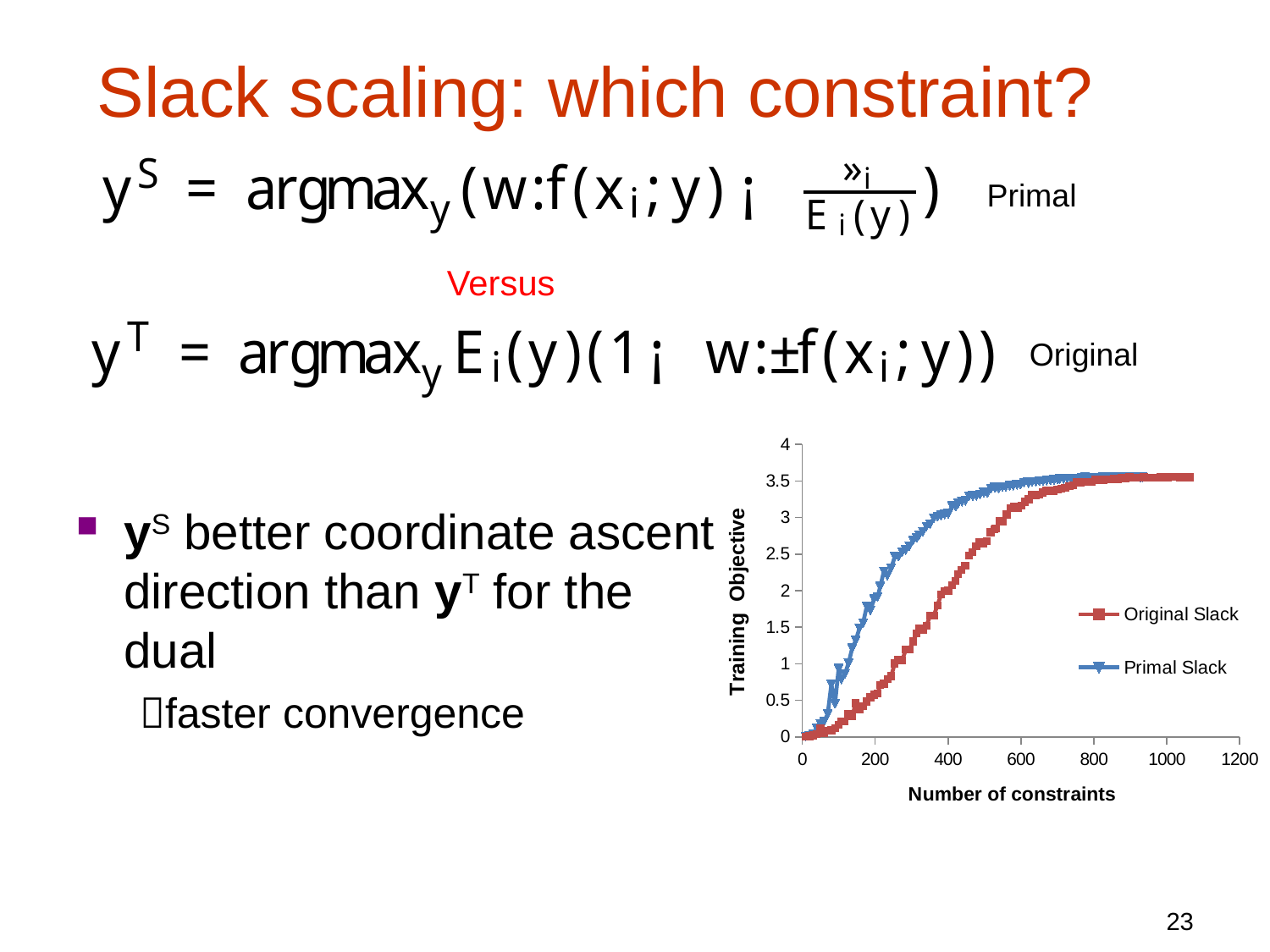
What are the two series named in the chart's legend? Original Slack and Primal Slack How many series does the chart's legend list? 2 Is the Training Objective for Original Slack at 600 constraints greater or less than 2.5? greater Which series reaches a Training Objective of 3 with fewer constraints? Primal Slack At 400 constraints, which series has the higher Training Objective, Original Slack or Primal Slack? Primal Slack Does the Training Objective for Original Slack rise or fall as the number of constraints increases? rise At 100 constraints, which series has the higher Training Objective, Original Slack or Primal Slack? Primal Slack Is the highest Training Objective reached by Primal Slack greater or less than 4? less Is the Training Objective for Original Slack at 200 constraints greater or less than 1? less What is the label of the chart's x axis? Number of constraints What kind of chart is shown on the slide? line chart